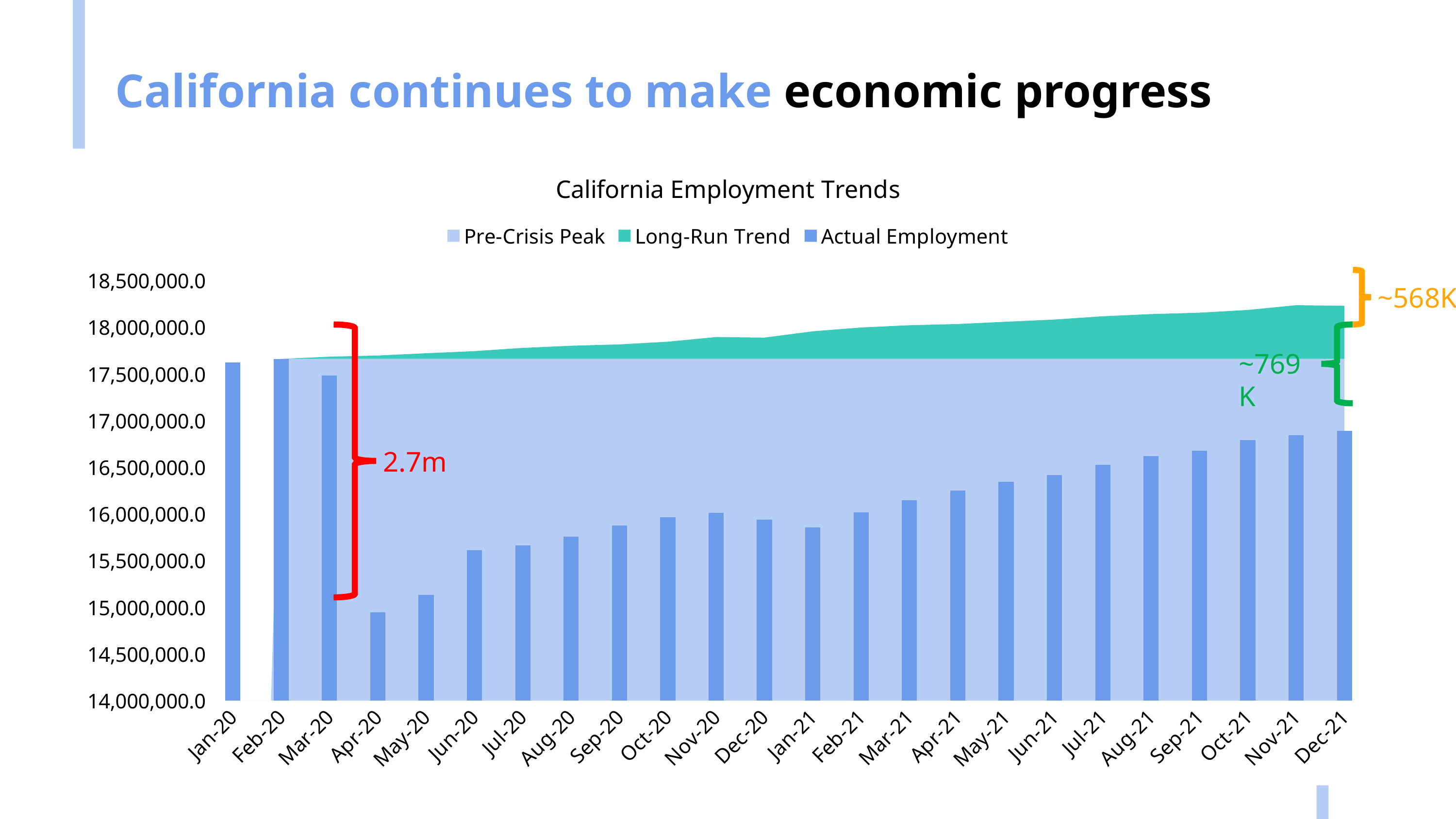
How many months are shown along the x axis? 24 Is the Actual Employment value for Dec-21 greater or less than 17,000,000.0? less Which has the higher Actual Employment bar, Nov-20 or Jan-21? Nov-20 Which month has the highest Actual Employment bar? Feb-20 Which series is shown in green in the legend? Long-Run Trend Is the Actual Employment value for Apr-20 greater or less than 15,500,000.0? less Which month has the lowest Actual Employment bar? Apr-20 How many series does the legend list? 3 What is the title of the chart? California Employment Trends Do the Actual Employment bars generally rise or fall from Apr-20 to Dec-21? rise Is the Actual Employment value for Jan-20 greater or less than 17,500,000.0? greater